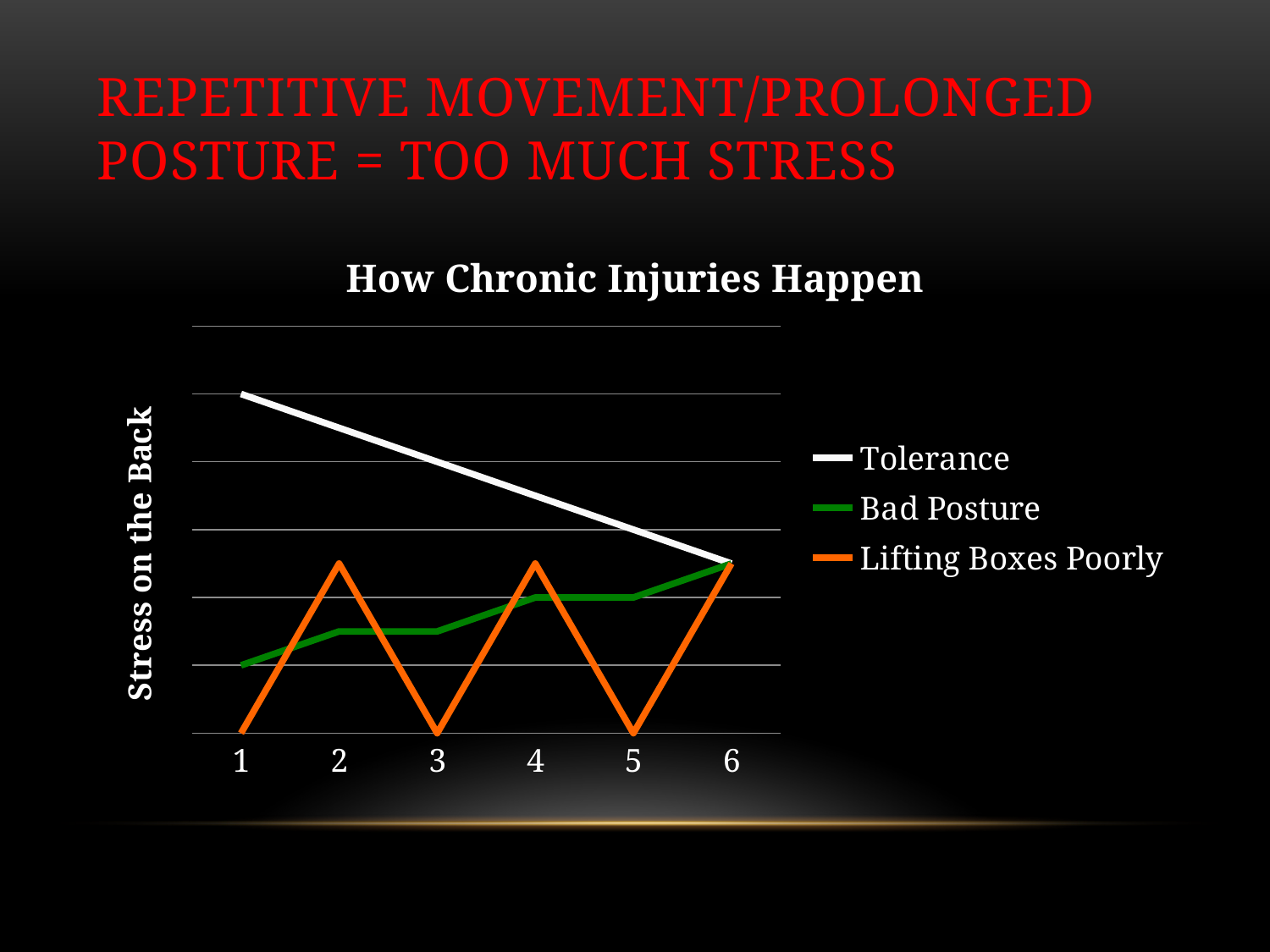
At point 3, which is larger: Bad Posture or Lifting Boxes Poorly? Bad Posture How many points are plotted along the x axis of the "How Chronic Injuries Happen" chart? 6 At point 2, which is larger: Bad Posture or Lifting Boxes Poorly? Lifting Boxes Poorly What kind of chart is shown under the title "How Chronic Injuries Happen"? Line chart What is the title of the chart on the slide? How Chronic Injuries Happen How many series does the legend of the "How Chronic Injuries Happen" chart list? 3 At point 1, which series has the highest value? Tolerance Does the Bad Posture line rise or fall from point 1 to point 6? Rise What is the label on the vertical axis of the chart? Stress on the Back At point 1, which series has the lowest value? Lifting Boxes Poorly At point 5, which is larger: Tolerance or Bad Posture? Tolerance Does the Tolerance line rise or fall from point 1 to point 6? Fall